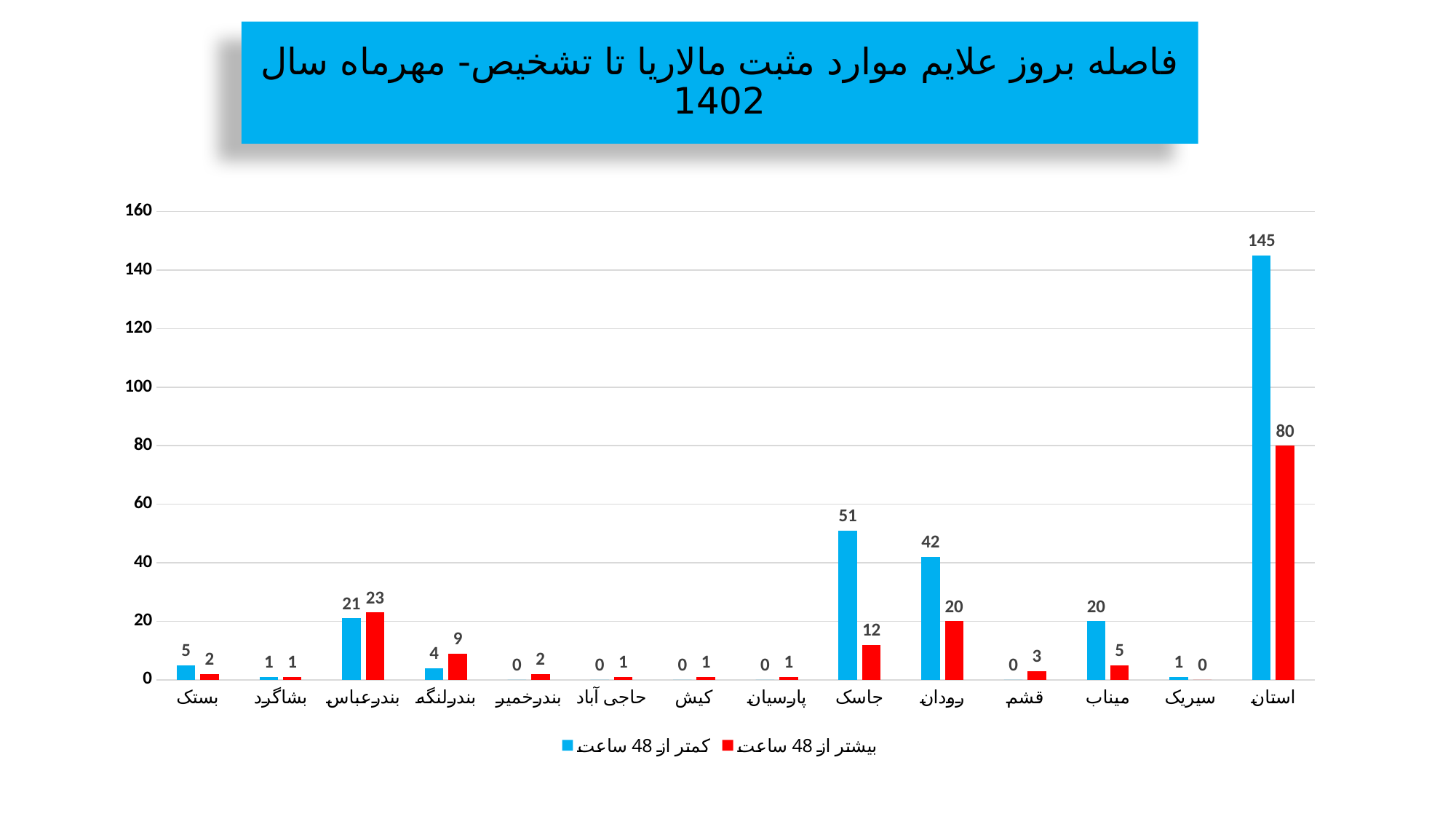
What is the difference between the blue and red bars for استان? 65 How many series does the legend list? 2 How many categories are shown on the x axis? 14 Is the blue bar for استان greater or less than 140? greater What kind of chart is shown on the slide? bar chart Which category has the highest blue bar? استان What is the difference between the blue bars for جاسک and رودان? 9 For بندرعباس, which bar is larger, the blue or the red? red What is the value of the blue bar for جاسک? 51 What is the value of the red bar for استان? 80 What is the value of the red bar for بندرلنگه? 9 What is the value of the blue bar for میناب? 20